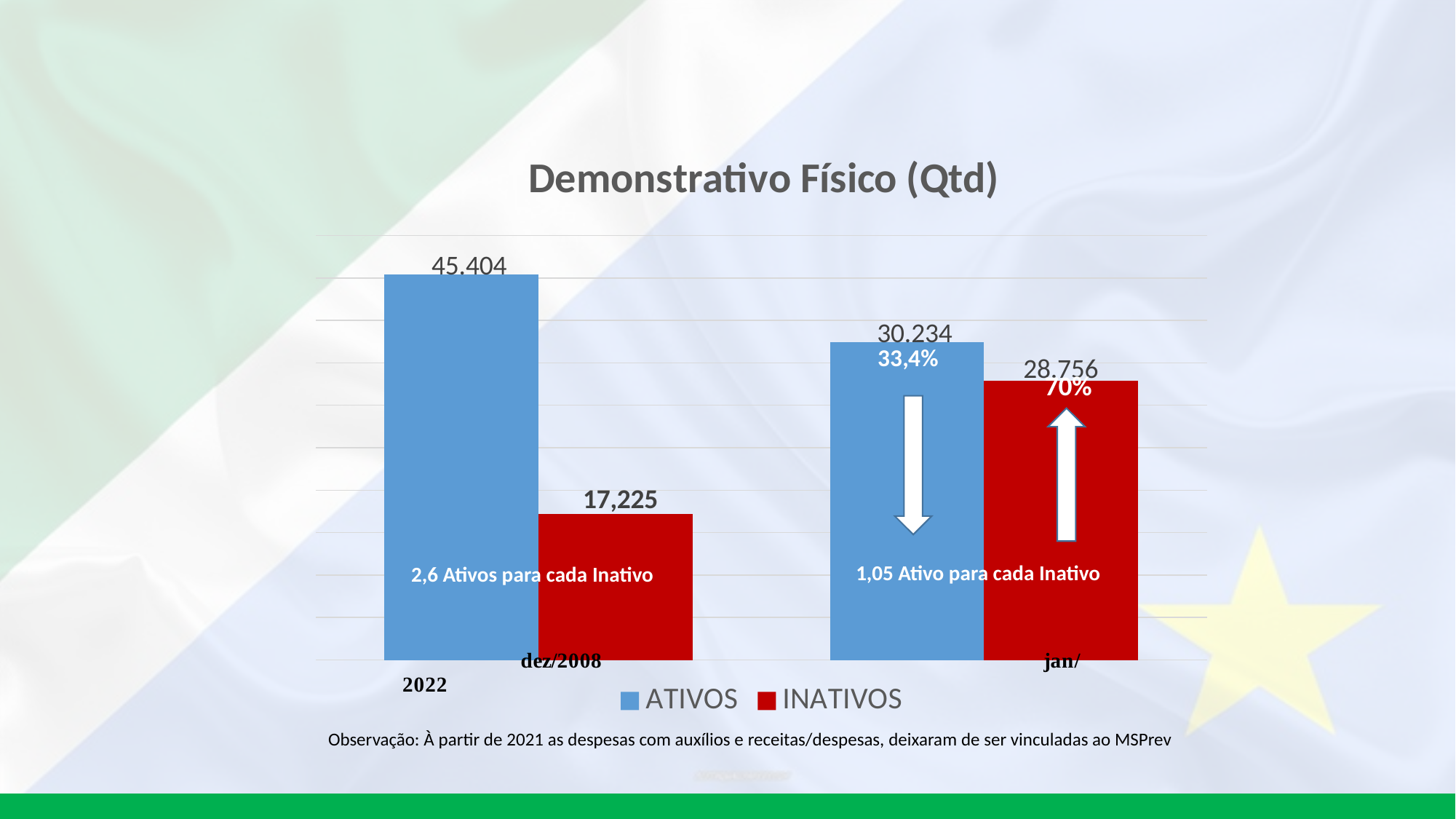
What is the value of INATIVOS for jan/2022? 28.756 Which bar has the lowest value in the chart? INATIVOS for dez/2008 Which bar has the highest value in the chart? ATIVOS for dez/2008 What is the value of INATIVOS for dez/2008? 17,225 What type of chart is shown on the slide? bar chart Does the ATIVOS series rise or fall from dez/2008 to jan/2022? fall What is the difference between ATIVOS and INATIVOS for jan/2022? 1.478 What is the title of the chart? Demonstrativo Físico (Qtd) How many series does the legend list? 2 What is the value of ATIVOS for dez/2008? 45.404 Which is larger for jan/2022, ATIVOS or INATIVOS? ATIVOS What is the value of ATIVOS for jan/2022? 30.234